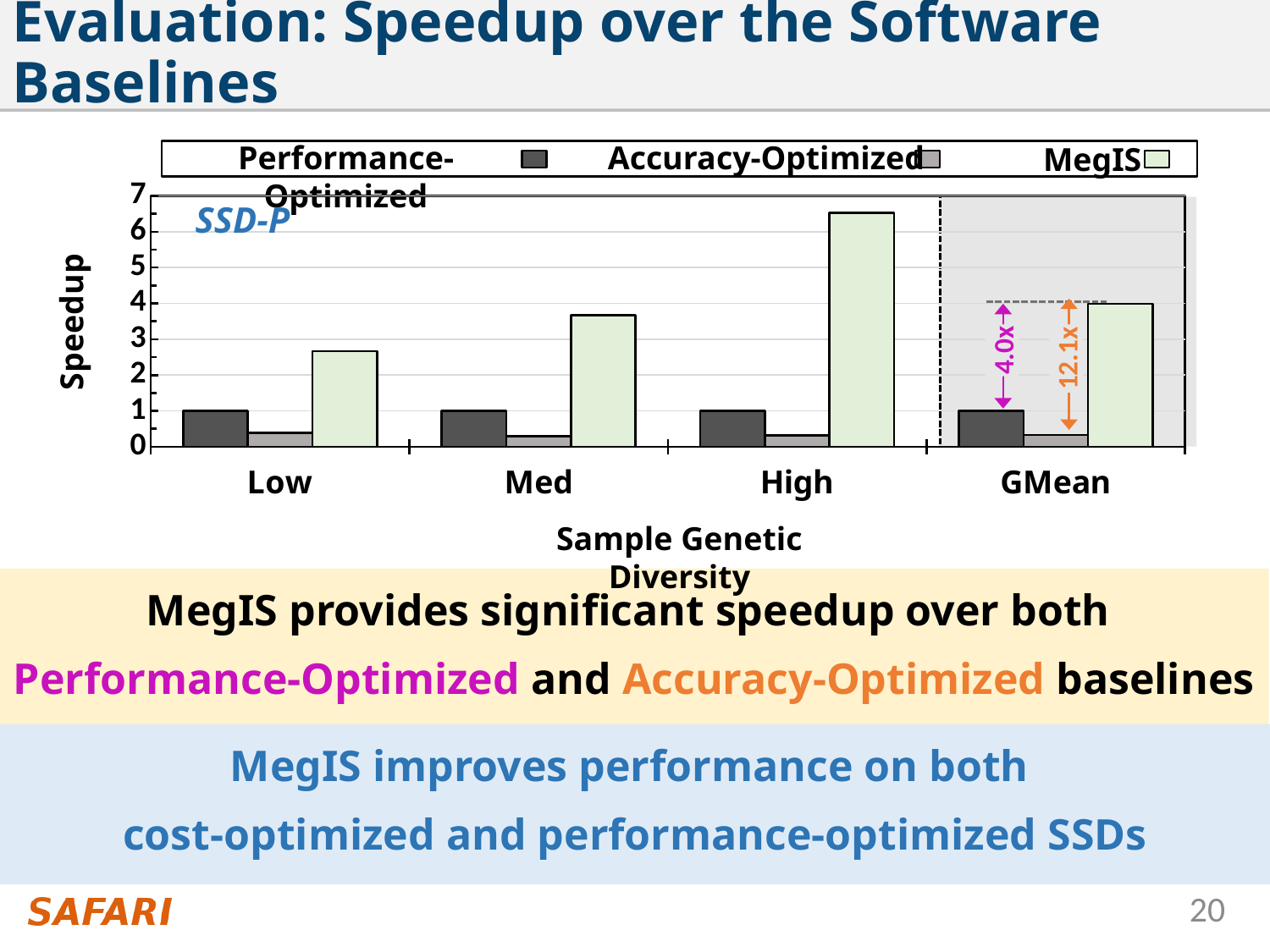
What is the label of the y axis? Speedup How many categories are shown on the x axis? 4 What is the speedup value of the Performance-Optimized bar for Low? 1 Is the MegIS value for High greater or less than 6? greater What speedup does the annotation show for MegIS over Accuracy-Optimized at GMean? 12.1x How many series does the legend list? 3 What kind of chart is shown on the slide? bar chart Which is larger for Med: the MegIS bar or the Accuracy-Optimized bar? MegIS For which category is the MegIS bar lowest? Low What speedup does the annotation show for MegIS over Performance-Optimized at GMean? 4.0x Is the MegIS value for Low greater or less than 3? less For which category is the MegIS bar highest? High